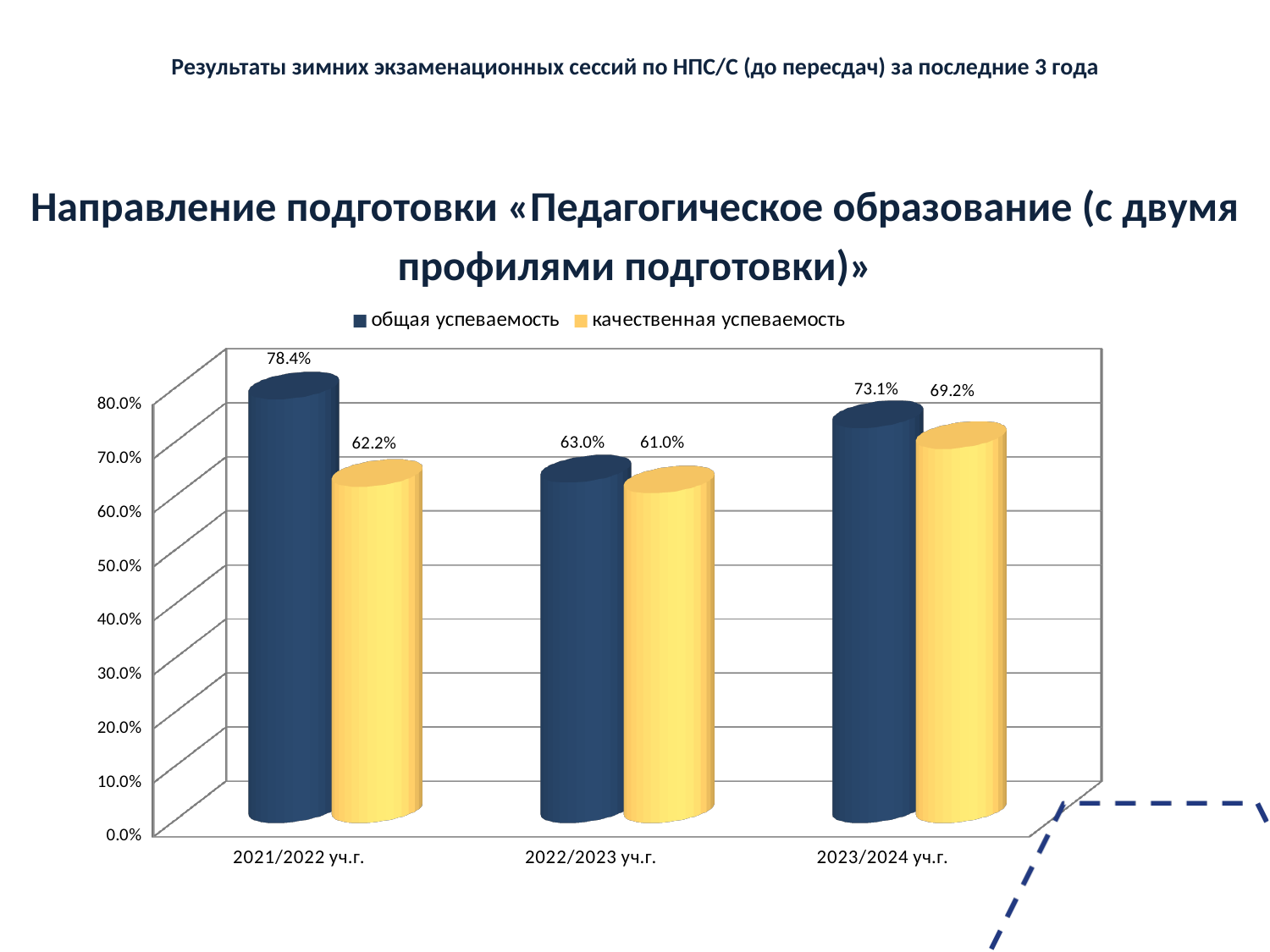
In which academic year is общая успеваемость the highest? 2021/2022 уч.г. What is the difference between общая успеваемость and качественная успеваемость in 2021/2022 уч.г.? 16.2% What is the value of качественная успеваемость for 2022/2023 уч.г.? 61.0% Which colour represents качественная успеваемость in the chart? yellow What kind of chart is shown on the slide? bar chart How many series does the legend list? 2 In which academic year is качественная успеваемость the lowest? 2022/2023 уч.г. Is the value of общая успеваемость for 2022/2023 уч.г. greater or less than 70.0%? less What is the value of общая успеваемость for 2021/2022 уч.г.? 78.4% What is the value of качественная успеваемость for 2023/2024 уч.г.? 69.2% Which is larger: общая успеваемость in 2023/2024 уч.г. or общая успеваемость in 2022/2023 уч.г.? 2023/2024 уч.г. How many academic years are shown on the x axis? 3